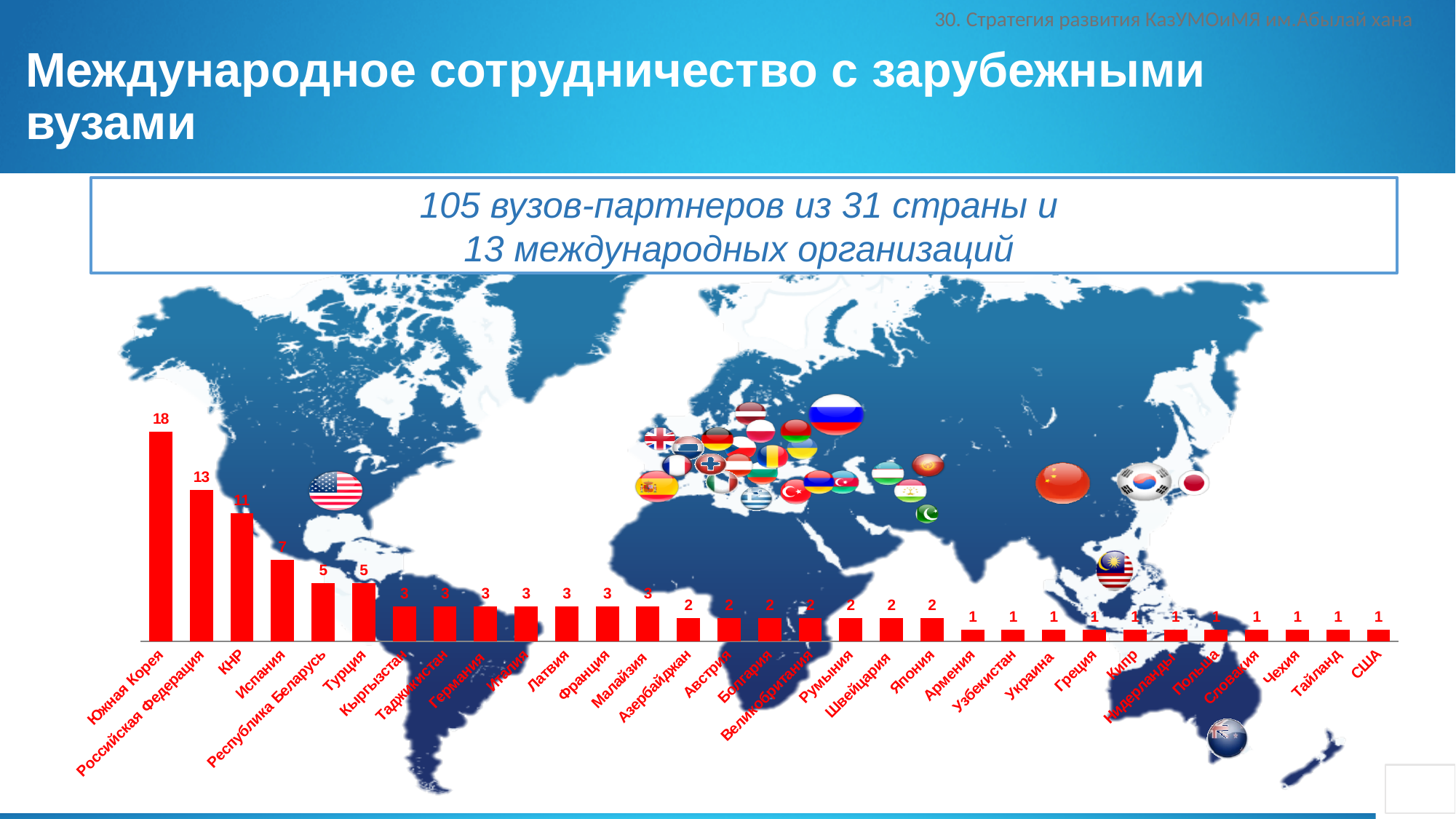
What is the value for Малайзия? 3 What is the value for Испания? 7 What is the value for Российская Федерация? 13 What is the value for Южная Корея? 18 What is the difference between the values for Южная Корея and КНР? 7 What is the difference between the values for Российская Федерация and Испания? 6 Which has a larger value, КНР or Турция? КНР Which has a larger value, Япония or Латвия? Латвия How many countries are shown in the chart? 31 Do the values rise or fall from left to right along the x axis? Fall What kind of chart is shown on the slide? Bar chart Which country has the highest value in the chart? Южная Корея